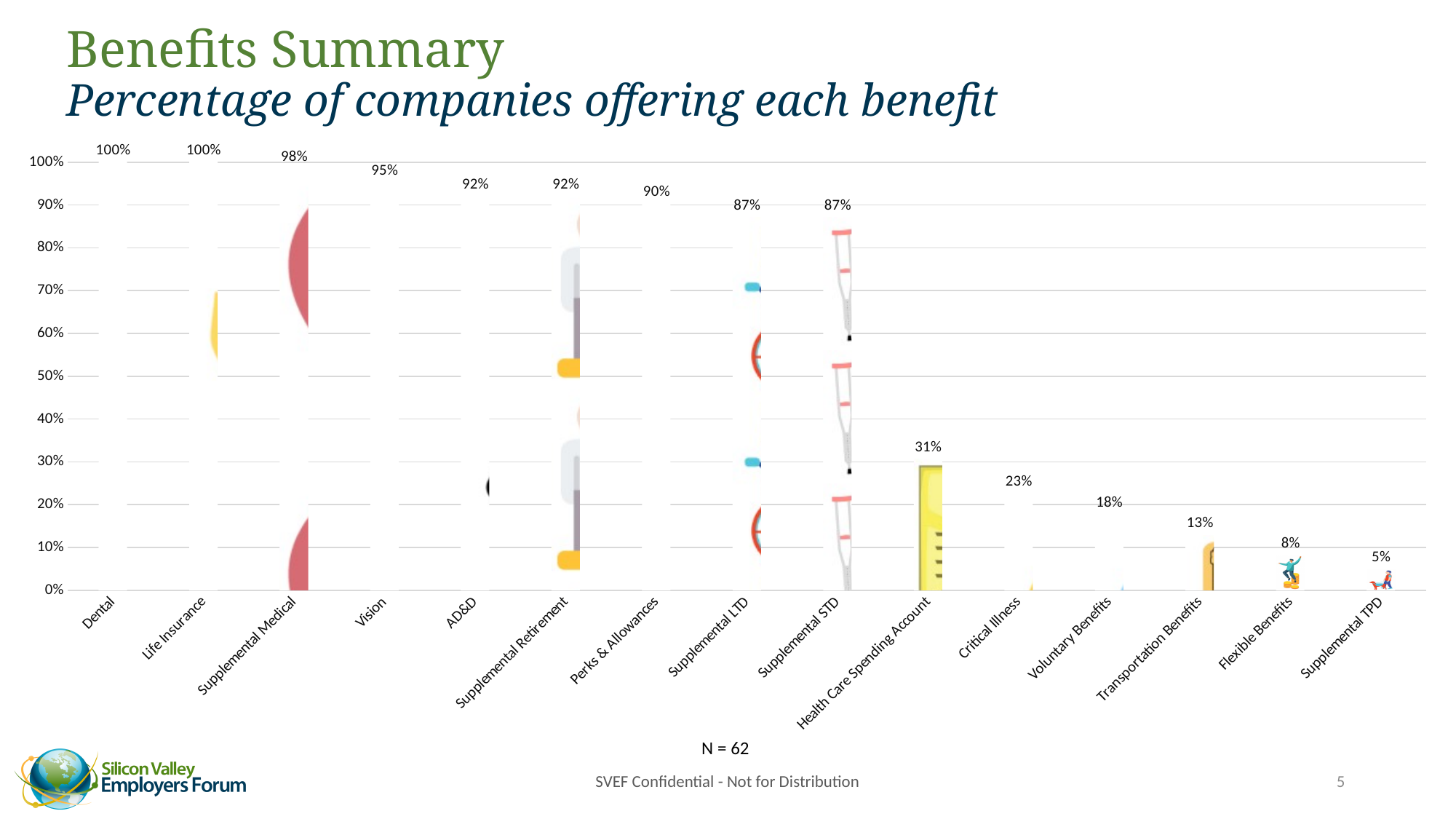
How many benefit categories are shown on the x axis? 15 What percentage of companies offer Supplemental STD? 87% Do the values generally rise or fall from left to right along the x axis? Fall Which benefit has the lowest percentage of companies offering it? Supplemental TPD What kind of chart is shown on the slide? Bar chart What percentage of companies offer a Health Care Spending Account? 31% What is the difference between the percentage for Supplemental Medical and the percentage for Perks & Allowances? 8% What percentage of companies offer Transportation Benefits? 13% Which is larger, the percentage for Voluntary Benefits or the percentage for Health Care Spending Account? Health Care Spending Account What sample size (N) is stated below the chart? N = 62 What is the difference between the percentage for Critical Illness and the percentage for Flexible Benefits? 15% What percentage of companies offer Vision? 95%